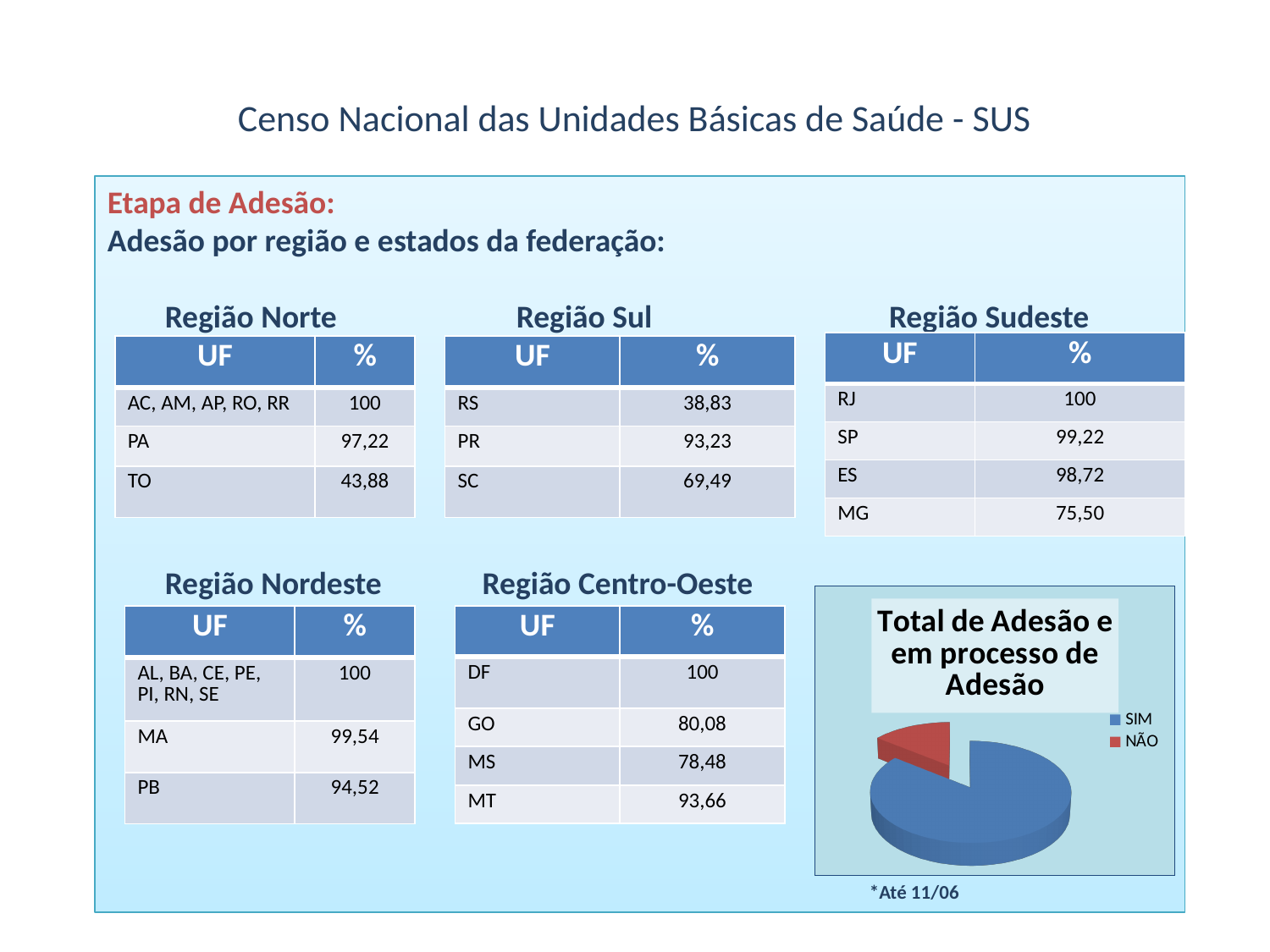
What is the title of the pie chart? Total de Adesão e em processo de Adesão What kind of chart is shown on the slide? pie chart What colour is the NÃO slice in the pie chart? red How many slices does the pie chart have? 2 Which slice of the pie chart is the largest? SIM In the pie chart, which is larger, SIM or NÃO? SIM Which slice of the pie chart is the smallest? NÃO How many entries does the legend of the pie chart list? 2 What are the two legend entries of the pie chart? SIM and NÃO